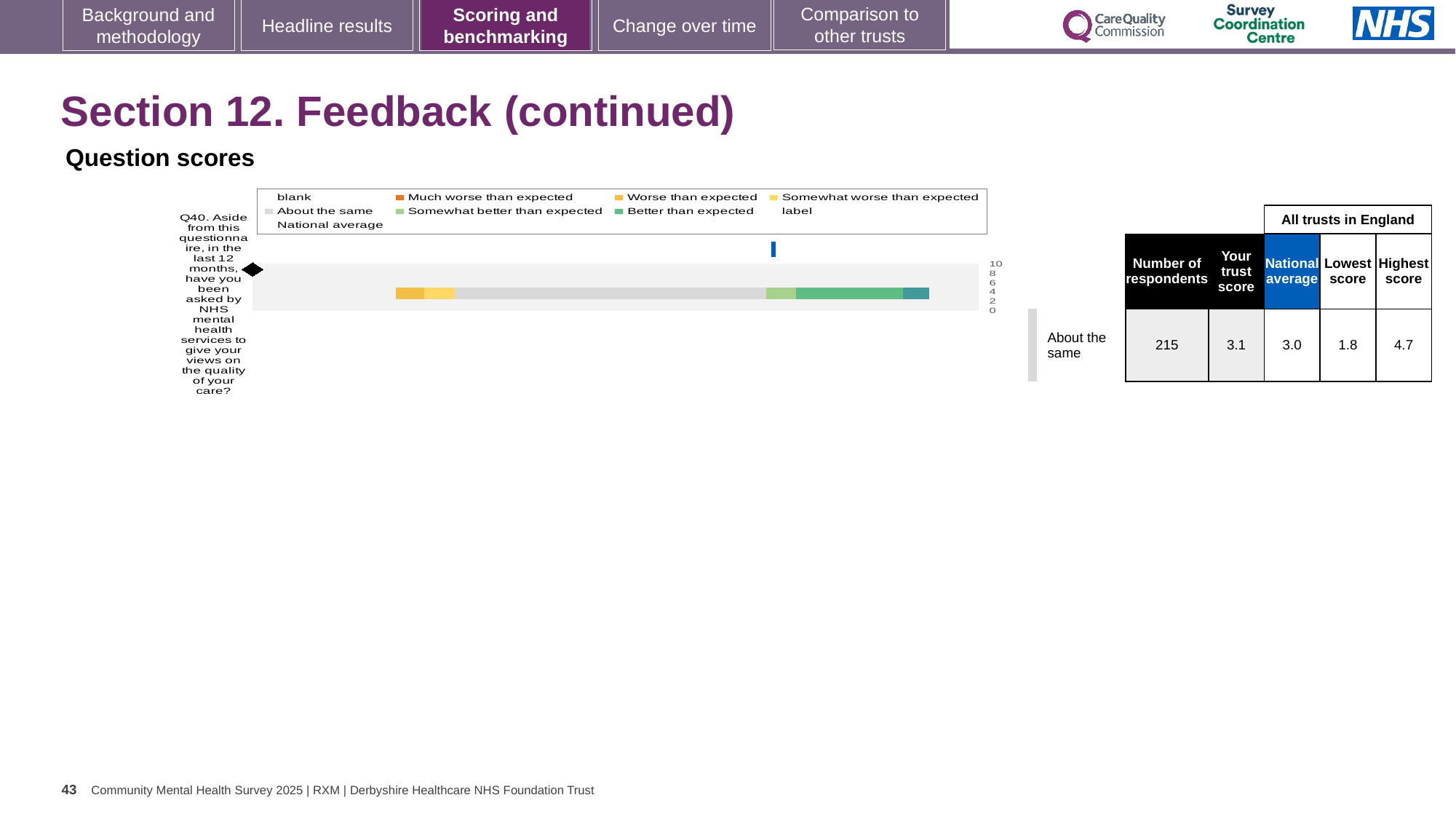
What is the difference between your trust score and the national average for Q40? 0.1 How many questions (categories) are plotted in the chart? 1 Which question number is plotted in the chart? Q40 What is the highest score among all trusts in England for Q40? 4.7 Which is larger for Q40, your trust score or the national average? Your trust score What benchmark category is shown next to the chart for Q40? About the same What is the number of respondents for Q40? 215 What is the difference between the highest score and the lowest score for Q40? 2.9 What is 'Your trust score' for Q40? 3.1 What is the national average score for Q40? 3.0 What is the lowest score among all trusts in England for Q40? 1.8 What kind of chart is shown under 'Question scores'? bar chart